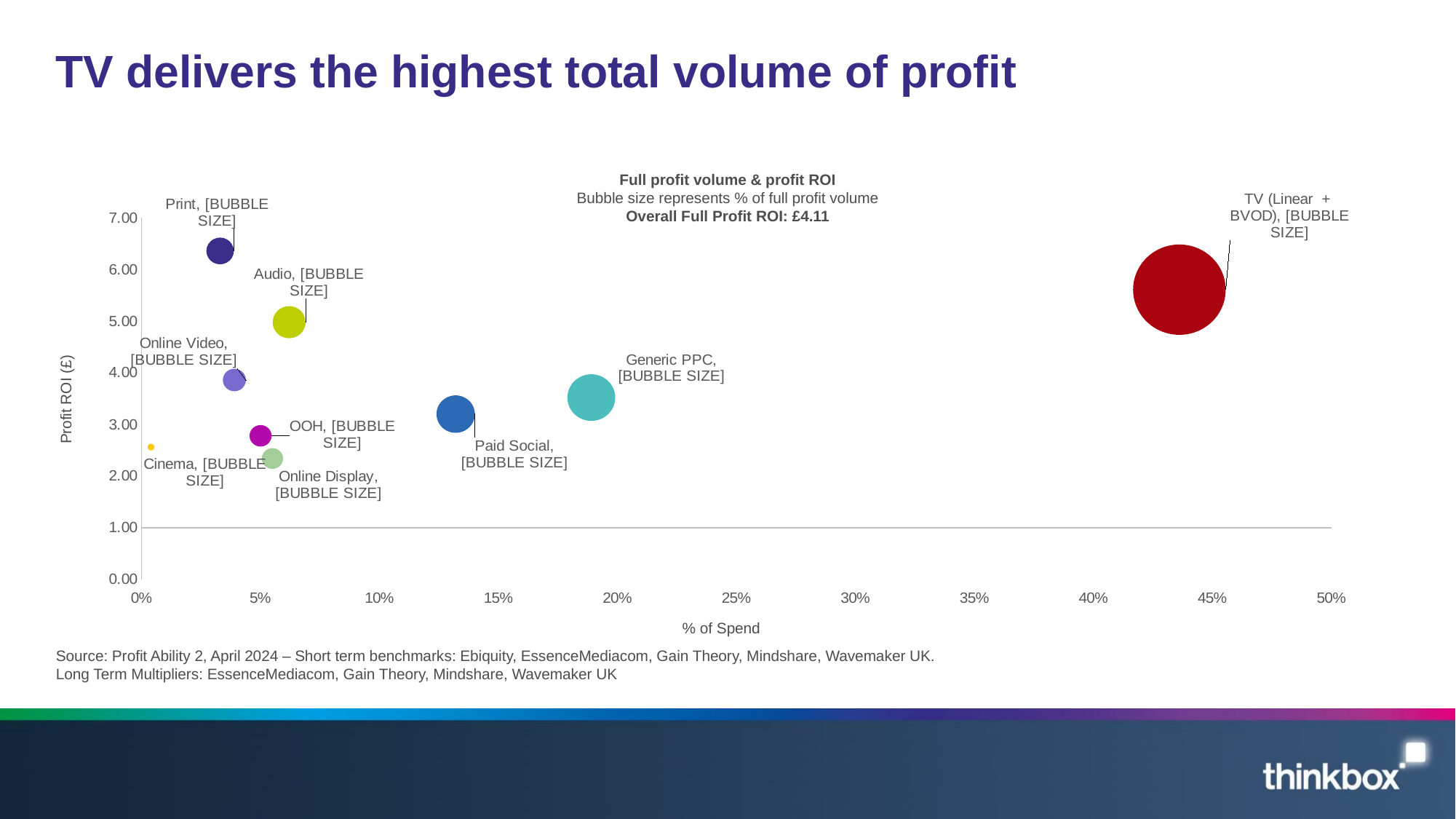
Is the Profit ROI for TV (Linear + BVOD) greater or less than 5.00? greater Is the % of Spend for Paid Social greater or less than 15%? less Which channel has the largest bubble, i.e. the largest share of full profit volume? TV (Linear + BVOD) Which has the higher Profit ROI, Audio or Paid Social? Audio How many media channels (bubbles) are plotted on the chart? 9 What Overall Full Profit ROI is stated in the chart's subtitle? £4.11 Which has the higher % of Spend, Generic PPC or Paid Social? Generic PPC Which channel has the highest Profit ROI on the chart? Print Is the Profit ROI for Print greater or less than 6.00? greater Which channel has the highest % of Spend on the chart? TV (Linear + BVOD) What kind of chart is shown on the slide? bubble chart Which channel has the smallest bubble on the chart? Cinema